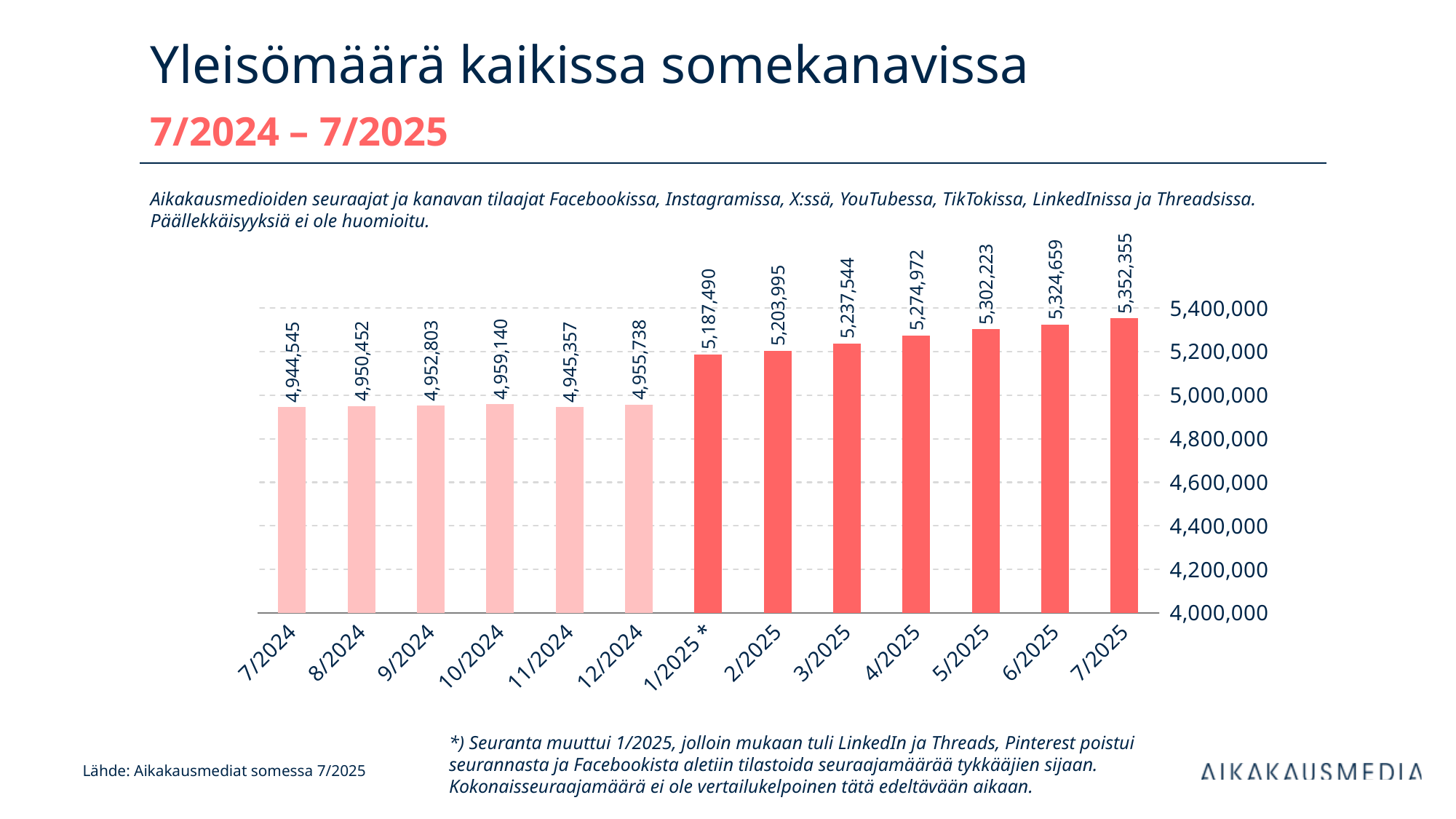
Is the value for 3/2025 greater or less than 5,200,000? greater What is the difference between the values for 7/2025 and 7/2024? 407,810 Which is larger, the value for 11/2024 or the value for 12/2024? 12/2024 How many months are shown on the x axis? 13 What kind of chart is shown on the slide? bar chart Which month has the lowest value? 7/2024 What is the difference between the values for 1/2025 and 12/2024? 231,752 Do the values generally rise or fall from 1/2025 to 7/2025? rise Which month has the highest value? 7/2025 What is the value for 7/2025? 5,352,355 What is the value for 1/2025? 5,187,490 What is the value for 10/2024? 4,959,140